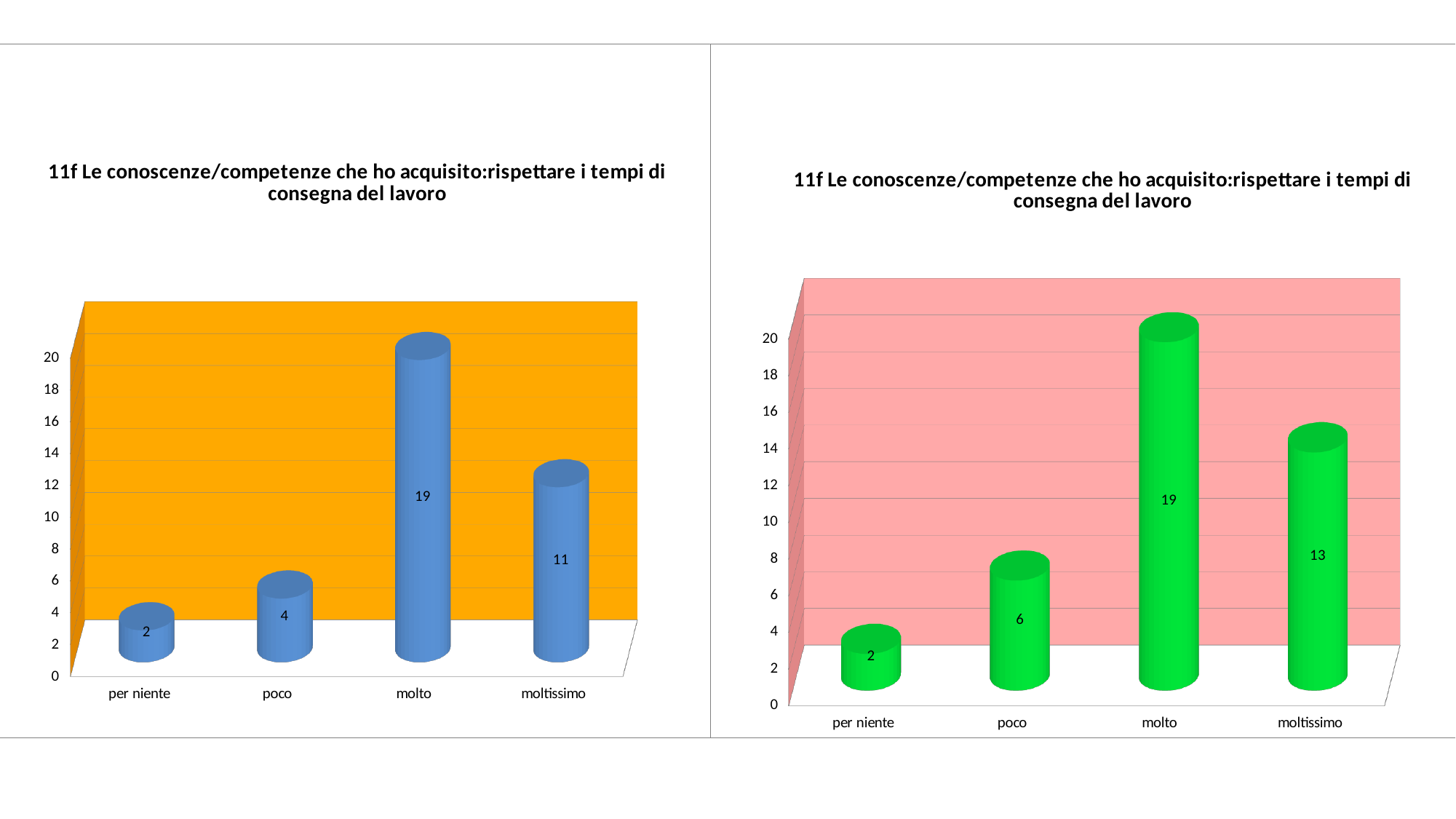
In the left chart, what is the value for "molto"? 19 In the left chart, which category has the lowest value? per niente What kind of chart is the right chart? bar chart In the left chart, what is the value for "moltissimo"? 11 What colour are the bars in the right chart? green In the right chart, which category has the highest value? molto In the left chart, what is the difference between the values for "poco" and "per niente"? 2 In the right chart, what is the difference between the values for "molto" and "moltissimo"? 6 In the right chart, is the value for "moltissimo" greater or less than 10? greater In the right chart, what is the value for "poco"? 6 In the left chart, which is larger, the value for "poco" or the value for "moltissimo"? moltissimo How many categories are shown on the x axis of the left chart? 4